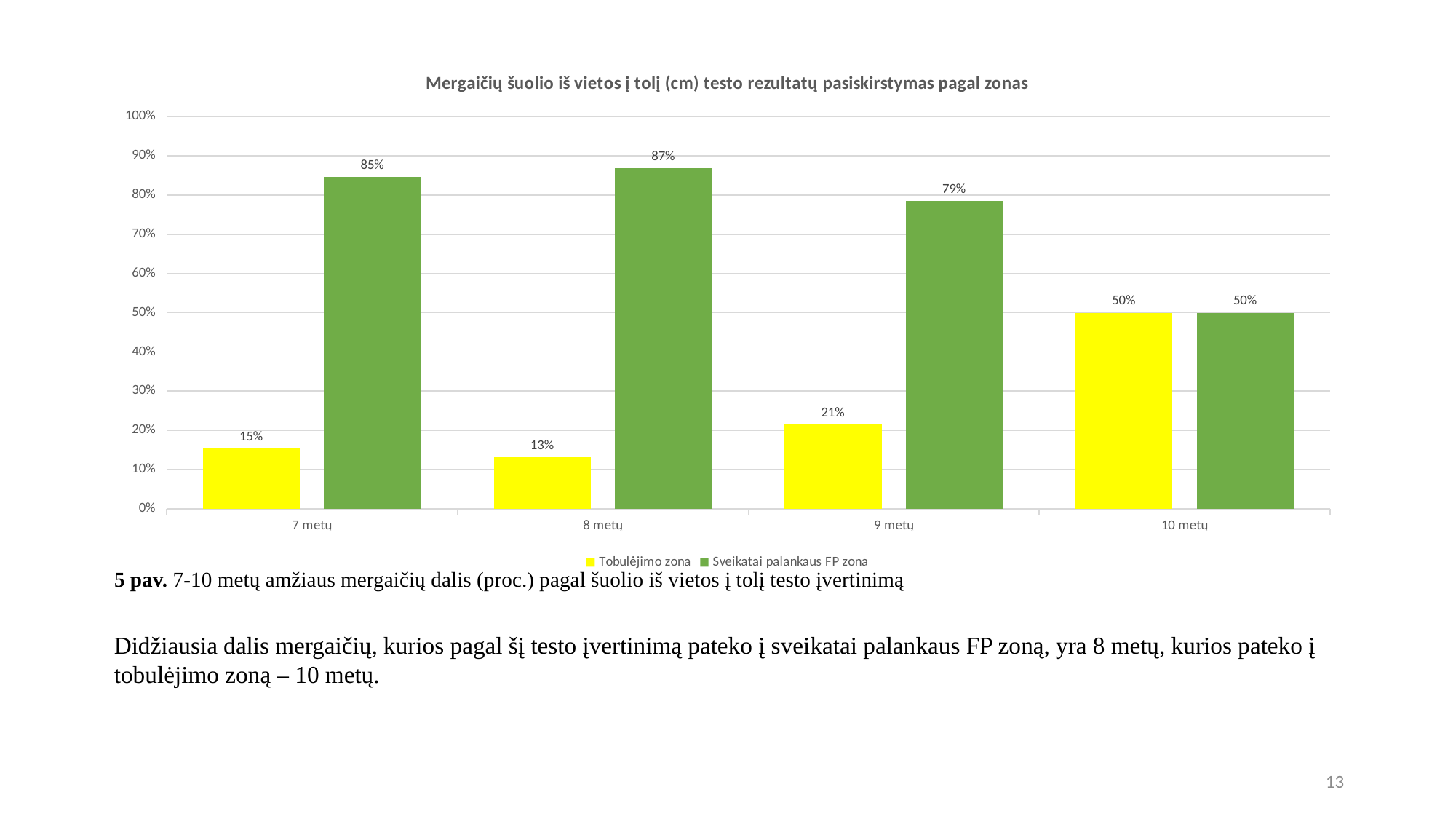
What colour represents Tobulėjimo zona in the chart? Yellow What is the value for Sveikatai palankaus FP zona at 8 metų? 87% What kind of chart is shown on the slide? Bar chart What is the value for Tobulėjimo zona at 9 metų? 21% How many series does the legend list? 2 What is the difference between Sveikatai palankaus FP zona and Tobulėjimo zona at 9 metų? 58% Which age group has the highest value for Sveikatai palankaus FP zona? 8 metų Which age group has the lowest value for Tobulėjimo zona? 8 metų How many age groups are shown on the x axis? 4 Does the value for Tobulėjimo zona rise or fall from 8 metų to 10 metų? Rise Which is larger at 7 metų: Tobulėjimo zona or Sveikatai palankaus FP zona? Sveikatai palankaus FP zona What is the value for Tobulėjimo zona at 7 metų? 15%